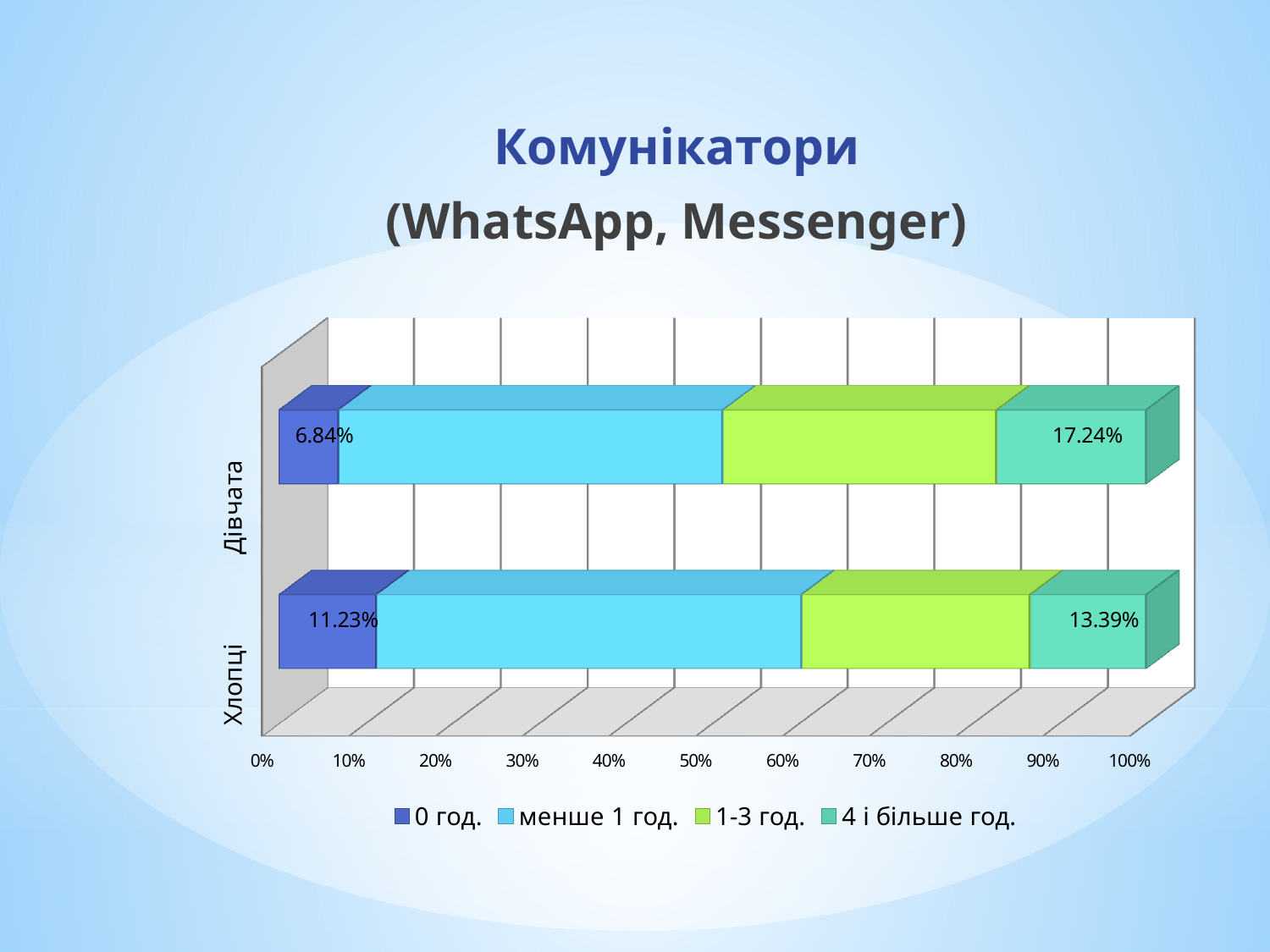
What is the value of the "0 год." segment for Хлопці? 11.23% How many series does the legend list? 4 What is the value of the "0 год." segment for Дівчата? 6.84% Which group has the larger "0 год." share, Дівчата or Хлопці? Хлопці Is the "менше 1 год." segment for Хлопці greater or less than 30 percentage points wide? greater What is the difference between the "0 год." values for Хлопці and Дівчата? 4.39 percentage points What type of chart is shown on the slide? Stacked bar chart How many categories (groups) are shown on the vertical axis? 2 Which series takes up the largest share of the Дівчата bar? менше 1 год. What is the value of the "4 і більше год." segment for Дівчата? 17.24% What is the value of the "4 і більше год." segment for Хлопці? 13.39% Which group has the larger "4 і більше год." share, Дівчата or Хлопці? Дівчата